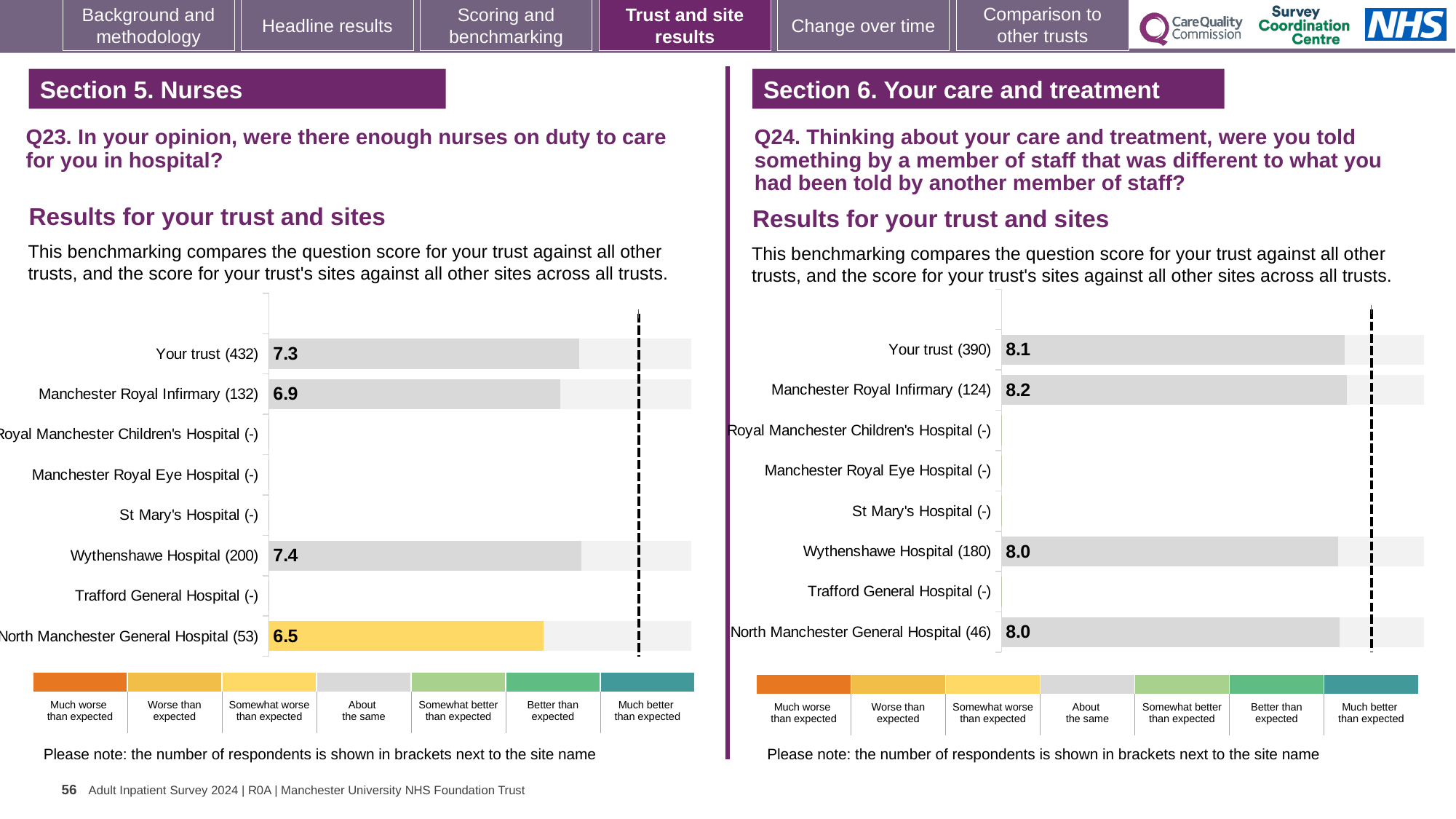
On the Q23 chart (left), which site has the lowest score? North Manchester General Hospital (53) On the Q23 chart (left), what is the difference between the scores for Wythenshawe Hospital (200) and North Manchester General Hospital (53)? 0.9 On the Q24 chart (right), what is the difference between the scores for Manchester Royal Infirmary (124) and Wythenshawe Hospital (180)? 0.2 On the Q23 chart (left), which row has the highest score? Wythenshawe Hospital (200) What type of chart is used on the Q23 chart (left)? Bar chart On the Q23 chart (left), which bar is coloured yellow rather than grey? North Manchester General Hospital (53) On the Q24 chart (right), what is the score for Manchester Royal Infirmary (124)? 8.2 On the Q23 chart (left), what is the score for North Manchester General Hospital (53)? 6.5 How many site/trust rows are listed on the Q24 chart (right)? 8 On the Q23 chart (left), which has the higher score: Manchester Royal Infirmary (132) or Wythenshawe Hospital (200)? Wythenshawe Hospital (200) On the Q24 chart (right), what is the score for Your trust (390)? 8.1 On the Q23 chart (left), what is the score for Your trust (432)? 7.3